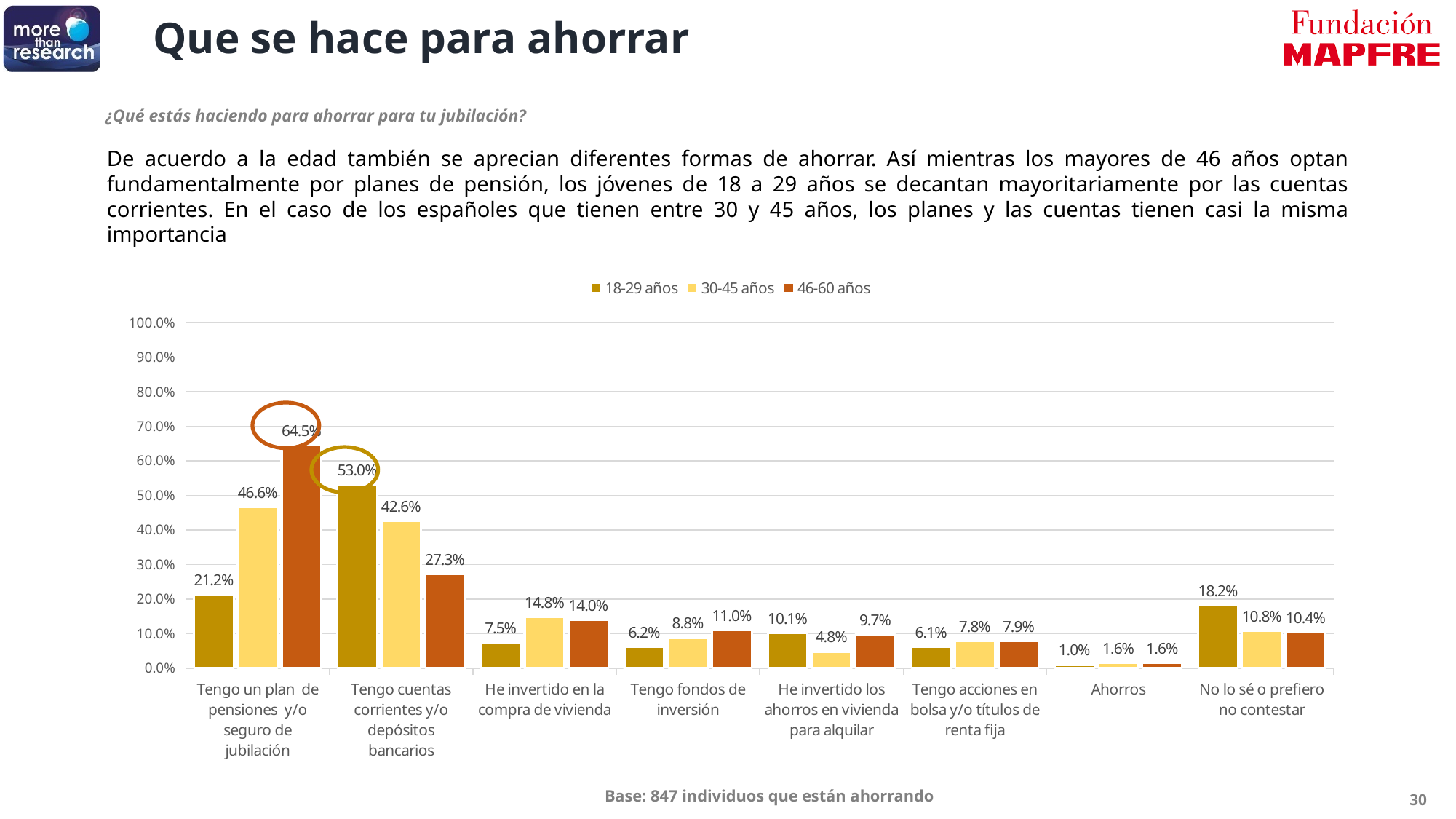
What kind of chart is shown on the slide? Bar chart Which category has the lowest value for the 46-60 años series? Ahorros Is the value for 30-45 años in 'Tengo cuentas corrientes y/o depósitos bancarios' greater or less than 40.0%? greater How many series does the legend list? 3 How many categories are shown on the x axis of the chart? 8 What is the value for 30-45 años in the category 'He invertido en la compra de vivienda'? 14.8% Which category has the highest value for the 18-29 años series? Tengo cuentas corrientes y/o depósitos bancarios What is the value for 18-29 años in the category 'No lo sé o prefiero no contestar'? 18.2% What is the value for 18-29 años in the category 'Tengo cuentas corrientes y/o depósitos bancarios'? 53.0% What is the value for 46-60 años in the category 'Tengo un plan de pensiones y/o seguro de jubilación'? 64.5% What is the difference between the 46-60 años and 18-29 años values in the category 'Tengo un plan de pensiones y/o seguro de jubilación'? 43.3% In the category 'He invertido los ahorros en vivienda para alquilar', which is larger: the value for 18-29 años or for 30-45 años? 18-29 años